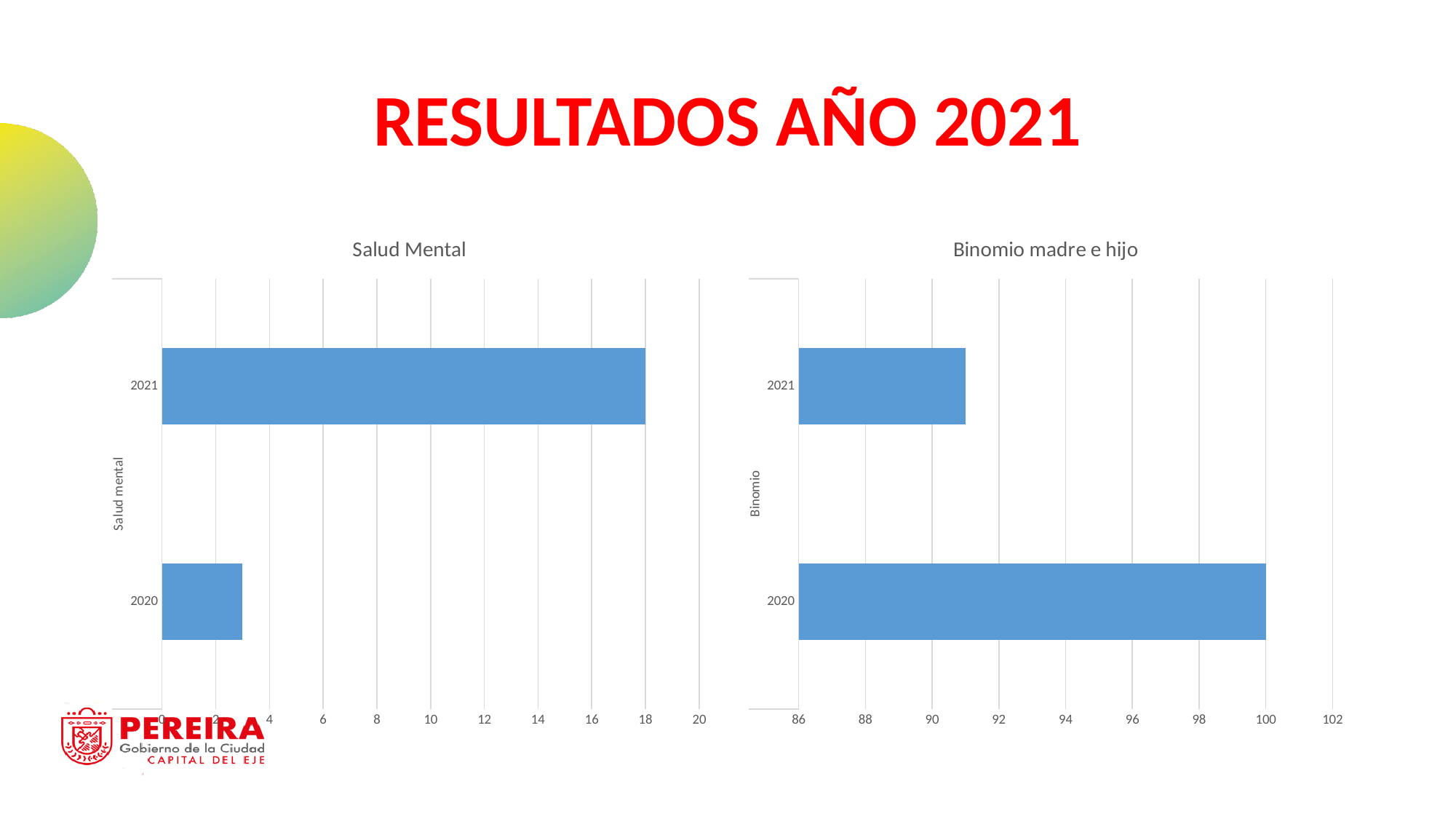
How many bars does the Salud Mental chart show? 2 In the Binomio madre e hijo chart, is the value for 2021 greater or less than 92? less What type of chart is the Binomio madre e hijo chart? bar chart In the Salud Mental chart, is the value for 2020 greater or less than 4? less In the Salud Mental chart, which year has the higher value? 2021 In the Binomio madre e hijo chart, is the value for 2021 greater or less than 90? greater In the Salud Mental chart, what is the value for 2021? 18 In the Binomio madre e hijo chart, is the value for 2020 larger or smaller than the value for 2021? larger In the Binomio madre e hijo chart, which year has the lower value? 2021 In the Binomio madre e hijo chart, what is the value for 2020? 100 In the Salud Mental chart, is the value for 2021 larger or smaller than the value for 2020? larger What is the title of the chart on the left side of the slide? Salud Mental